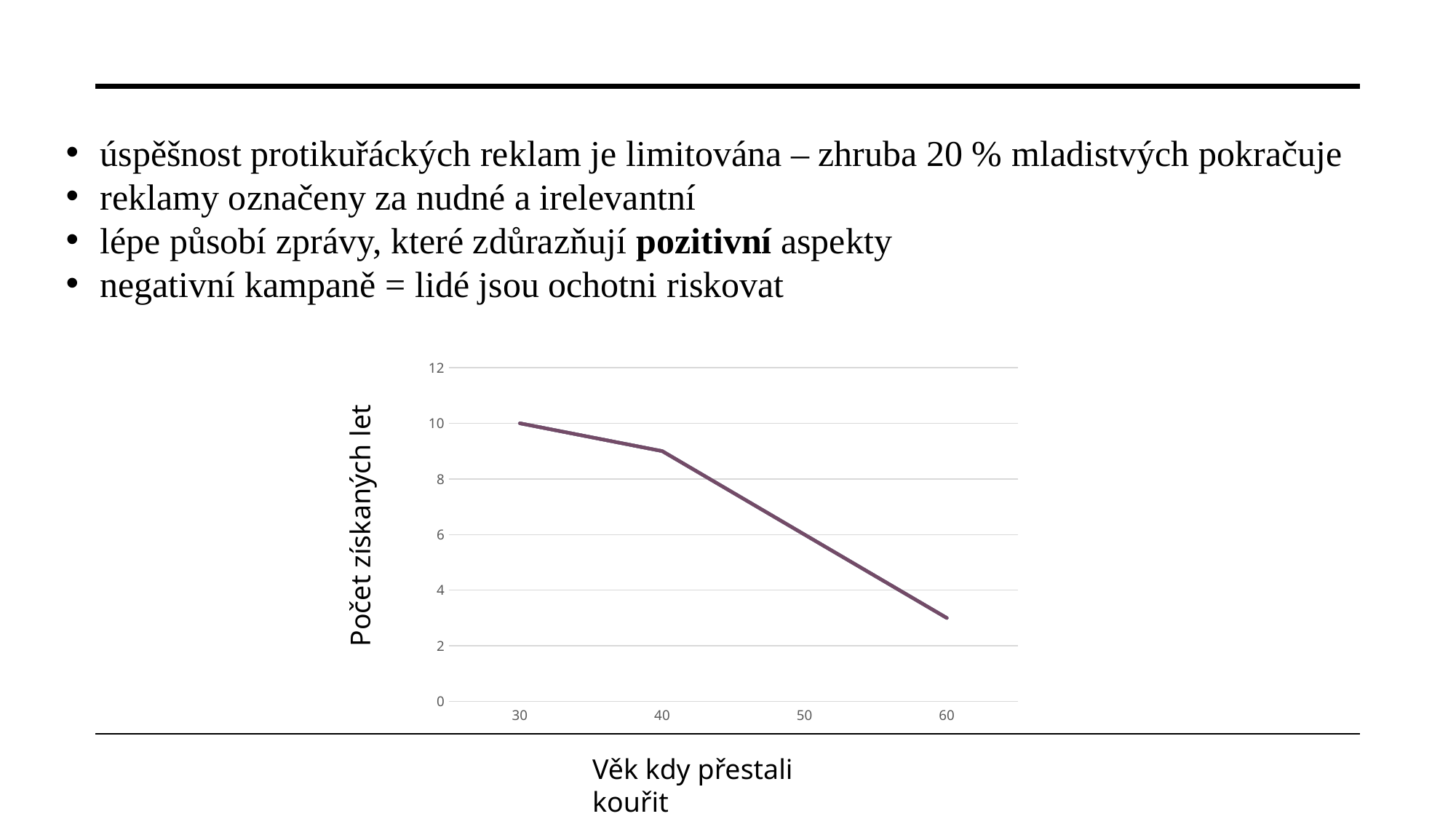
What is the title of the vertical axis? Počet získaných let Is the value for age 40 greater or less than 8? greater Which has a larger value, age 40 or age 50? 40 What is the difference between the values for age 30 and age 50? 4 Do the values rise or fall as the age of quitting increases along the x axis? fall At which age is the number of years gained lowest? 60 What kind of chart is shown on the slide? line chart How many data points are plotted on the line? 4 Is the value for age 60 greater or less than 4? less What is the value of 'Počet získaných let' for age 30? 10 At which age is the number of years gained highest? 30 What is the value of 'Počet získaných let' for age 50? 6